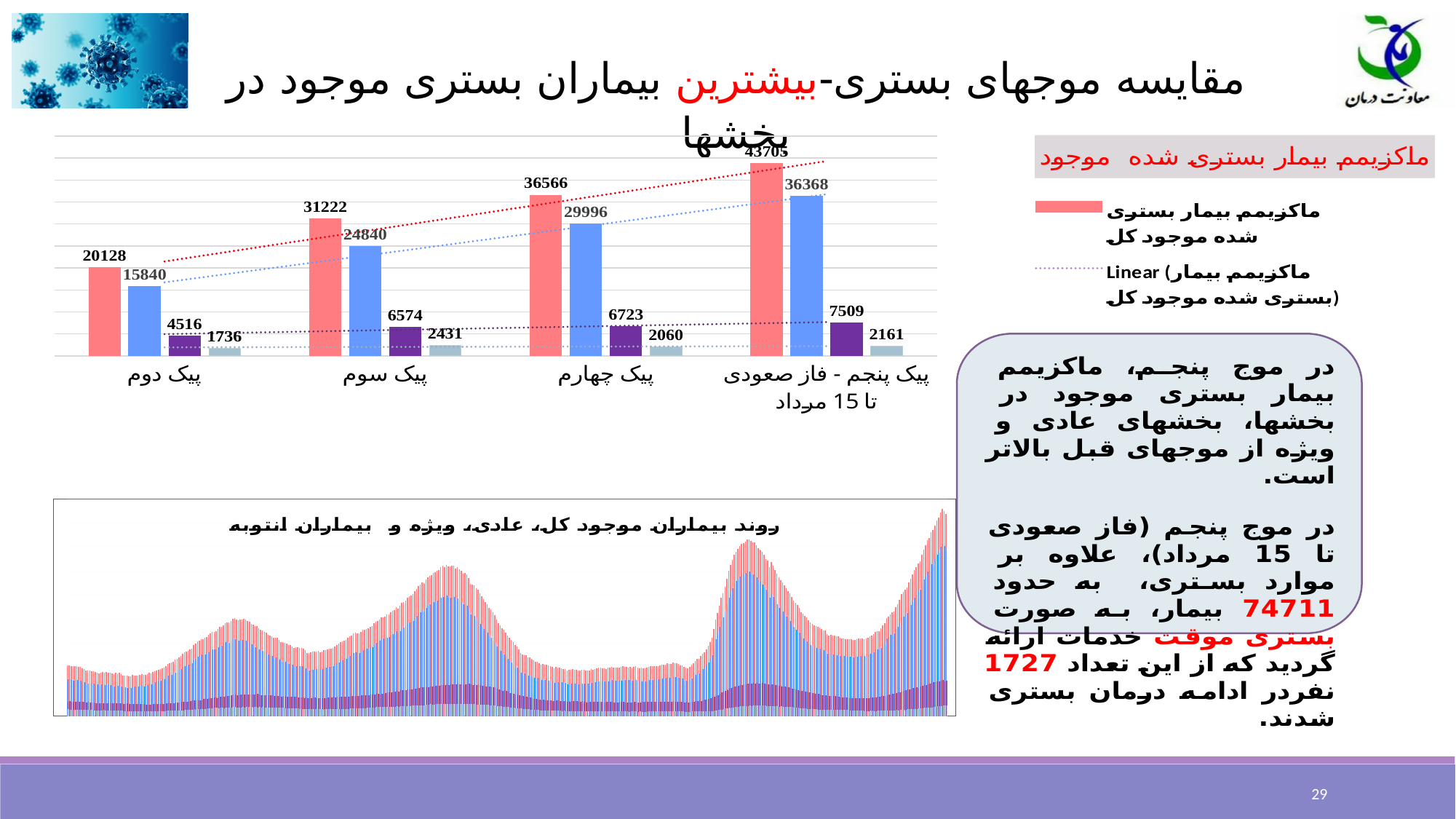
In the top bar chart, which category has the highest red bar? پیک پنجم - فاز صعودی تا 15 مرداد In the top bar chart, what is the difference between the red bar values for پیک چهارم and پیک سوم? 5344 In the top bar chart, what is the value of the blue bar for پیک چهارم? 29996 In the top bar chart, which is larger: the light gray bar for پیک سوم or the light gray bar for پیک چهارم? پیک سوم In the top bar chart, do the red bar values rise or fall from پیک دوم to پیک پنجم? rise What is the title of the bottom chart on the slide? روند بیماران موجود کل، عادی، ویژه و بیماران انتوبه In the top bar chart, which category has the lowest blue bar? پیک دوم In the top bar chart, what is the value of the purple bar for پیک سوم? 6574 How many categories are shown on the x axis of the top bar chart? 4 What kind of chart is the top chart on the slide? bar chart In the top bar chart, what is the value of the red bar (ماکزیمم بیمار بستری شده موجود کل) for پیک دوم? 20128 In the top bar chart, what is the value of the red bar for پیک پنجم - فاز صعودی تا 15 مرداد? 43705